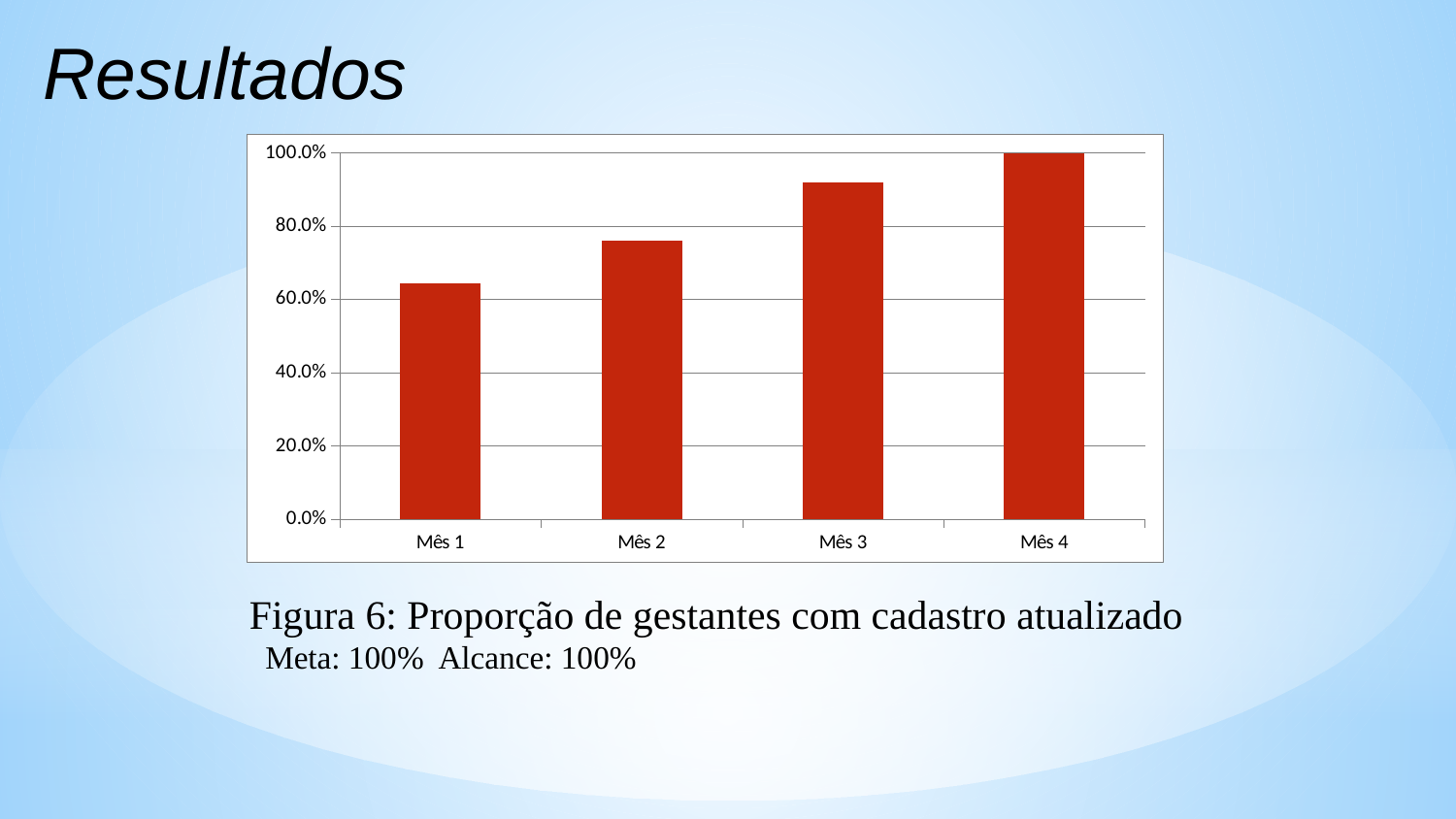
Which is larger, the value for Mês 2 or the value for Mês 3? Mês 3 Do the values rise or fall from Mês 1 to Mês 4? rise According to the caption, what does Figura 6 show? Proporção de gestantes com cadastro atualizado Is the value for Mês 1 greater or less than 60.0%? greater Which month has the lowest value on the chart? Mês 1 How many categories (months) are plotted on the chart? 4 Is the value for Mês 1 greater or less than 80.0%? less Is the value for Mês 2 greater or less than 80.0%? less What kind of chart is shown on the slide? bar chart What is the value for Mês 4? 100.0% Which month has the highest value on the chart? Mês 4